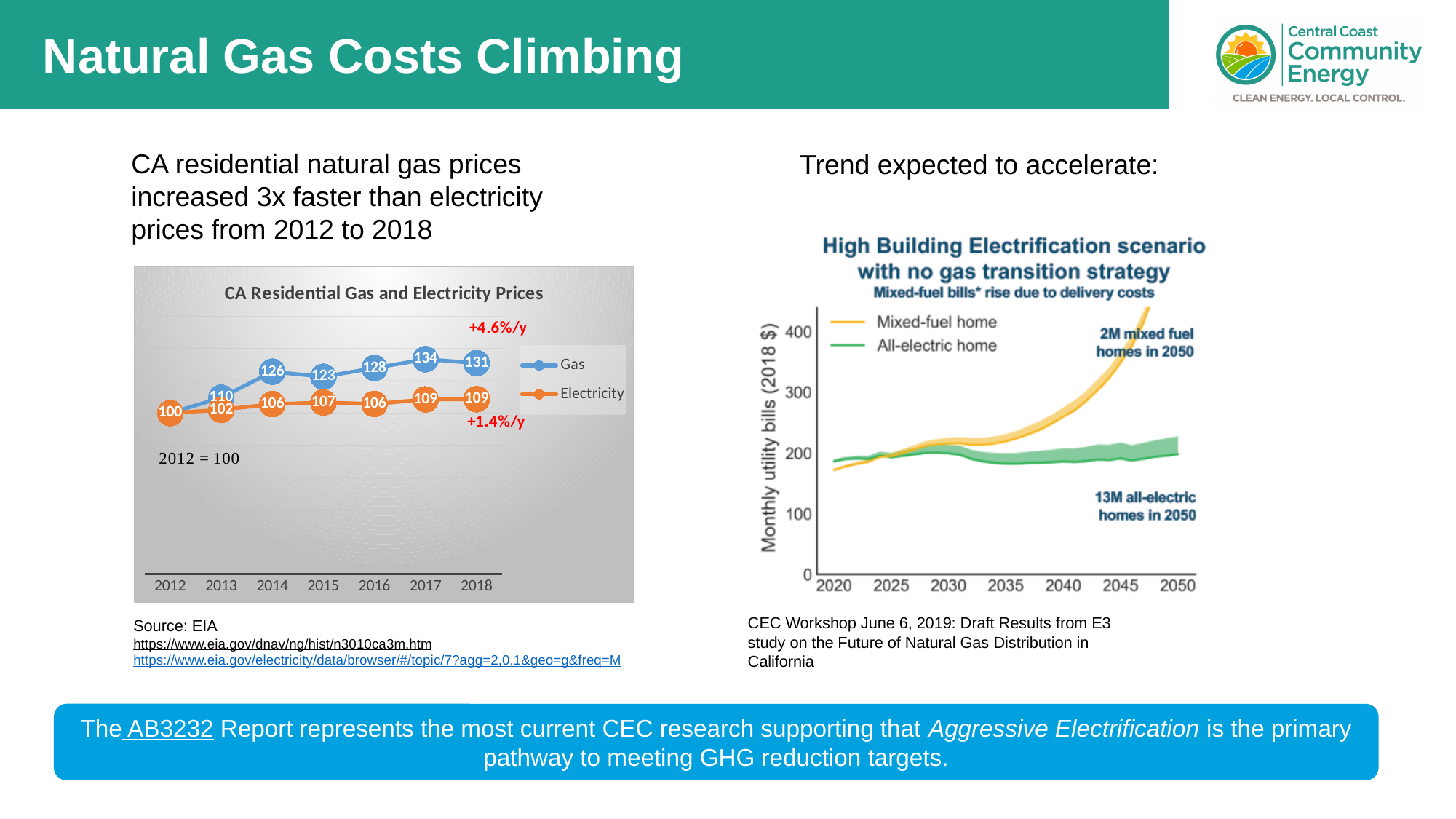
In the 'High Building Electrification scenario' chart, does the Mixed-fuel home line rise or fall from 2030 to 2050? Rise In the 'CA Residential Gas and Electricity Prices' chart, what is the difference between the Gas and Electricity values in 2018? 22 In the 'CA Residential Gas and Electricity Prices' chart, what is the Electricity value for 2015? 107 In the 'CA Residential Gas and Electricity Prices' chart, how many years are shown on the x axis? 7 In the 'CA Residential Gas and Electricity Prices' chart, which year has the highest Gas value? 2017 In the 'High Building Electrification scenario' chart, is the Mixed-fuel home value in 2045 greater or less than 300? greater What type of chart is the 'High Building Electrification scenario' chart on the right? Line chart In the 'CA Residential Gas and Electricity Prices' chart, how many series does the legend list? 2 In the 'High Building Electrification scenario' chart, is the All-electric home value in 2040 greater or less than 300? less In the 'CA Residential Gas and Electricity Prices' chart, what annual growth rate is annotated for Gas? +4.6%/y In the 'CA Residential Gas and Electricity Prices' chart, which is larger in 2014: the Gas value or the Electricity value? Gas In the 'CA Residential Gas and Electricity Prices' chart, what is the Gas value for 2017? 134